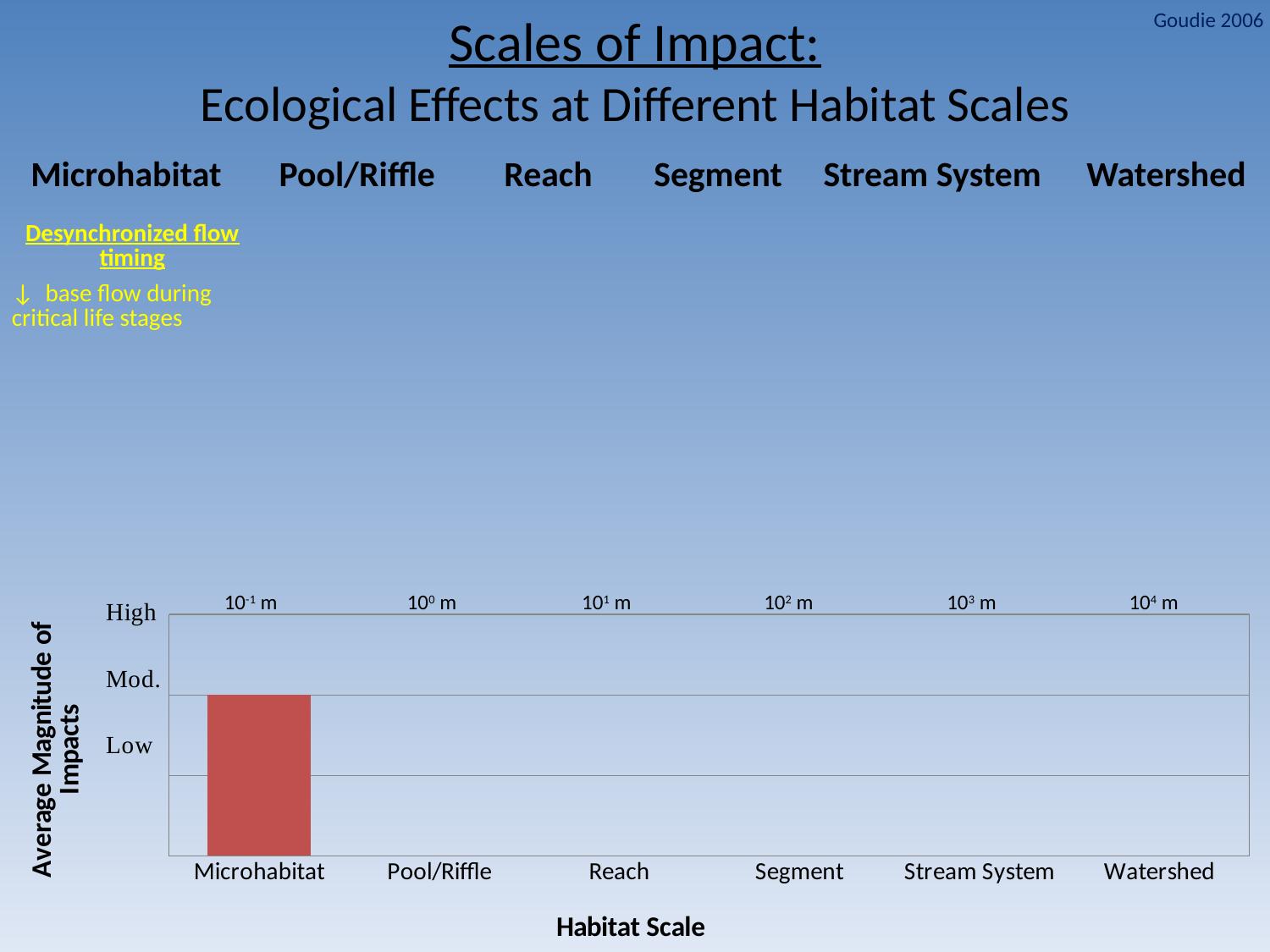
Which has a larger value in the chart, Microhabitat or Pool/Riffle? Microhabitat Which habitat scale category has the highest average magnitude of impacts in the chart? Microhabitat Which has a larger value in the chart, Watershed or Microhabitat? Microhabitat What is the title of the x axis of the chart? Habitat Scale What kind of chart is shown on the slide? bar chart What is the title of the y axis of the chart? Average Magnitude of Impacts How many categories in the chart have a visible bar plotted? 1 How many habitat scale categories are shown on the x axis of the chart? 6